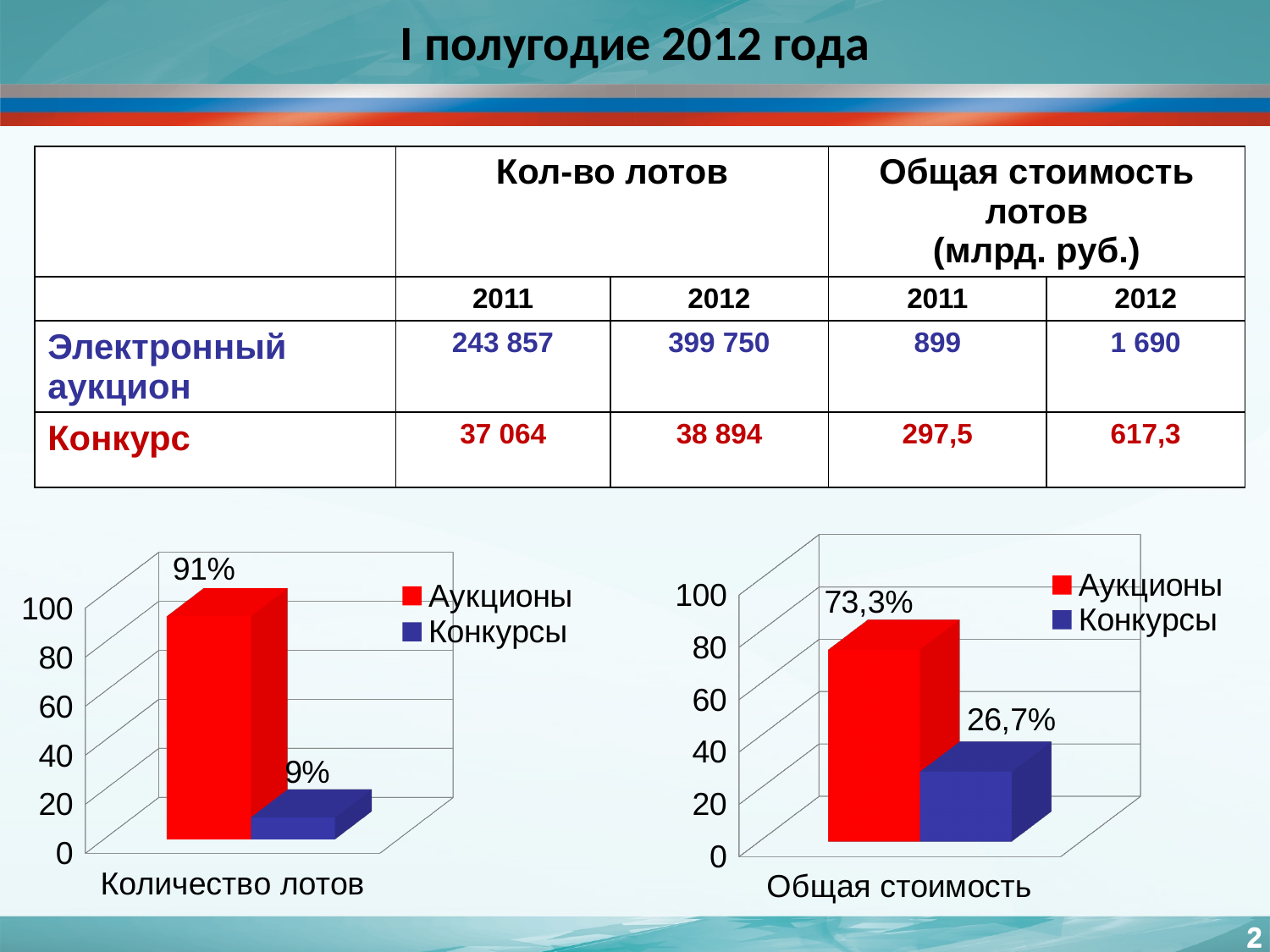
In the right chart (Общая стоимость), what colour are the Аукционы bars? red In the right chart (Общая стоимость), which series has the lower value? Конкурсы What kind of chart is the right chart (Общая стоимость)? bar chart In the right chart (Общая стоимость), is the value for Конкурсы greater or less than 40? less In the left chart (Количество лотов), what is the difference between the Аукционы and Конкурсы values? 82% In the left chart (Количество лотов), what is the value for Аукционы? 91% In the right chart (Общая стоимость), what is the value for Аукционы? 73,3% How many series does the legend of the left chart (Количество лотов) list? 2 In the right chart (Общая стоимость), what is the difference between the Аукционы and Конкурсы values? 46,6% In the right chart (Общая стоимость), what is the value for Конкурсы? 26,7% In the left chart (Количество лотов), what is the value for Конкурсы? 9% In the left chart (Количество лотов), which series has the higher value? Аукционы